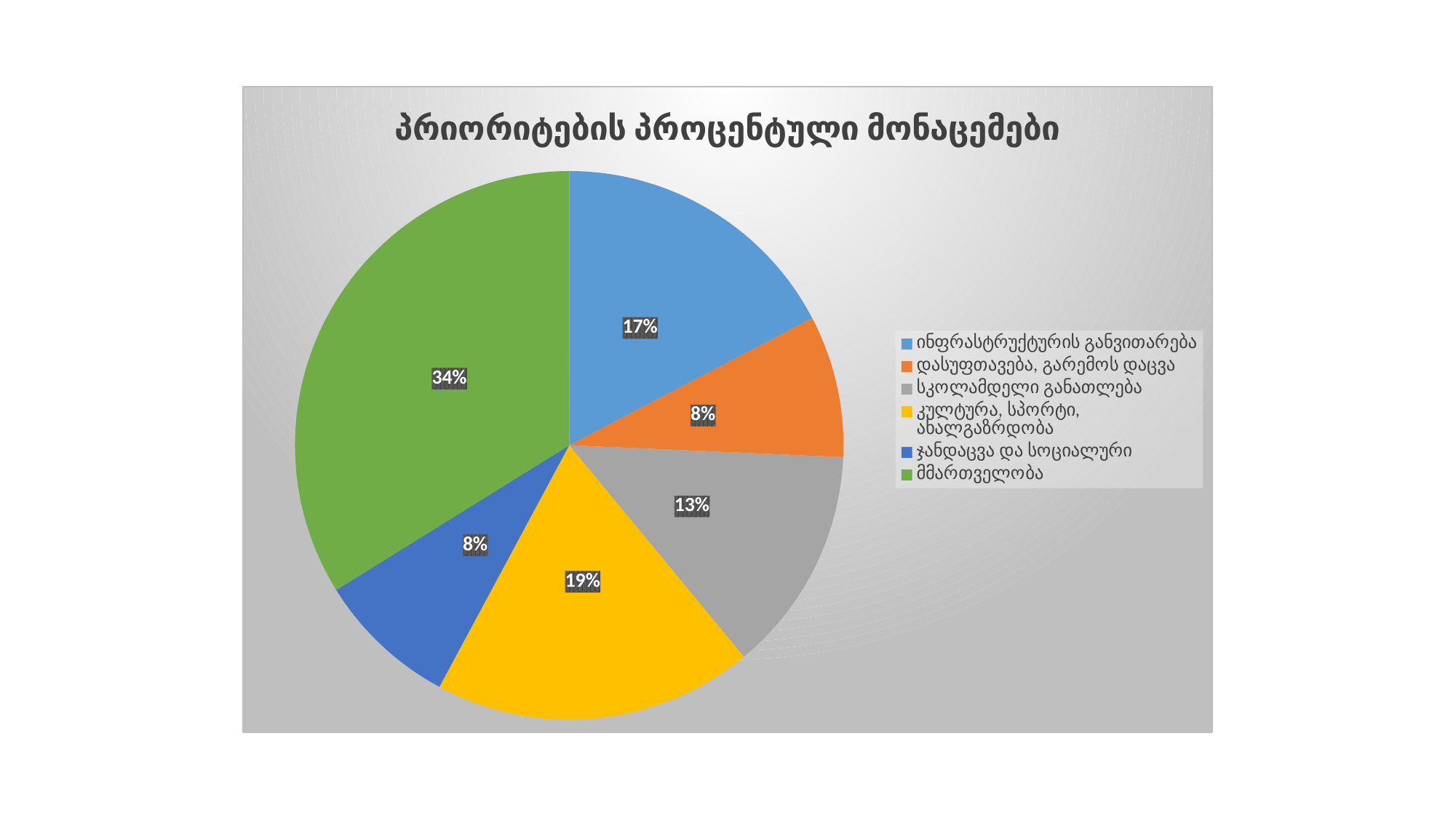
What kind of chart is shown on the slide? pie chart What is the value for სკოლამდელი განათლება? 13% What is the title of the chart? პრიორიტების პროცენტული მონაცემები Which category has the largest share of the pie? მმართველობა Which is larger, the share for ინფრასტრუქტურის განვითარება or the share for სკოლამდელი განათლება? ინფრასტრუქტურის განვითარება What is the value for კულტურა, სპორტი, ახალგაზრდობა? 19% How many slices does the pie chart have? 6 What is the difference between the shares of მმართველობა and კულტურა, სპორტი, ახალგაზრდობა? 15% What colour is the slice for დასუფთავება, გარემოს დაცვა? orange What is the value for ჯანდაცვა და სოციალური? 8% What share of the pie does მმართველობა have? 34% What is the value for ინფრასტრუქტურის განვითარება? 17%